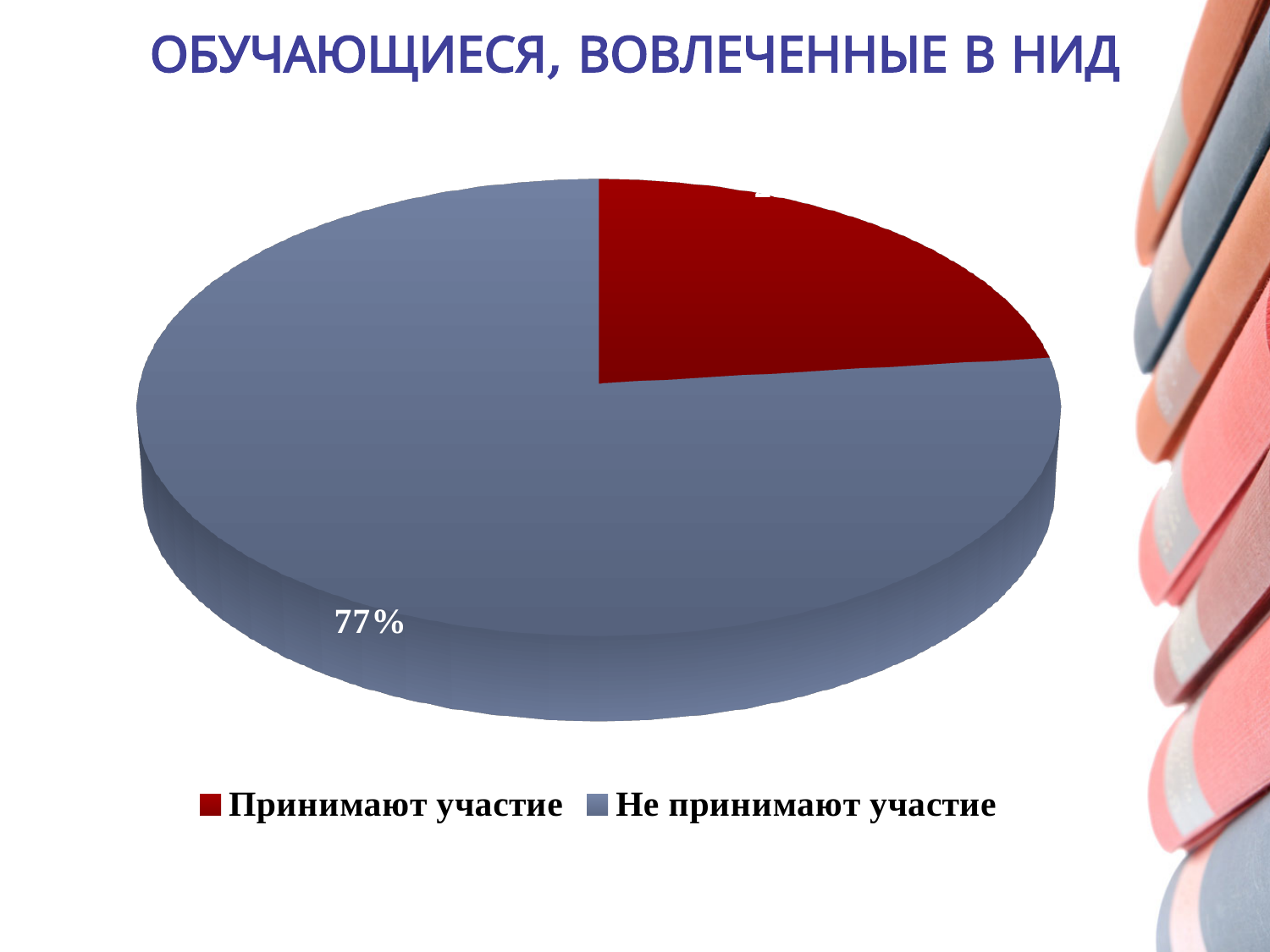
What kind of chart is shown on the slide? pie chart What colour is the 'Принимают участие' slice? red How many slices does the pie chart have? 2 What is the title of the chart on the slide? ОБУЧАЮЩИЕСЯ, ВОВЛЕЧЕННЫЕ В НИД Which slice is the smallest in the pie chart? Принимают участие How many entries does the legend list? 2 Is the share for 'Не принимают участие' greater or less than 50%? greater What percentage is shown for the 'Не принимают участие' slice? 77% Which is larger: the 'Принимают участие' slice or the 'Не принимают участие' slice? Не принимают участие Which slice is the largest in the pie chart? Не принимают участие